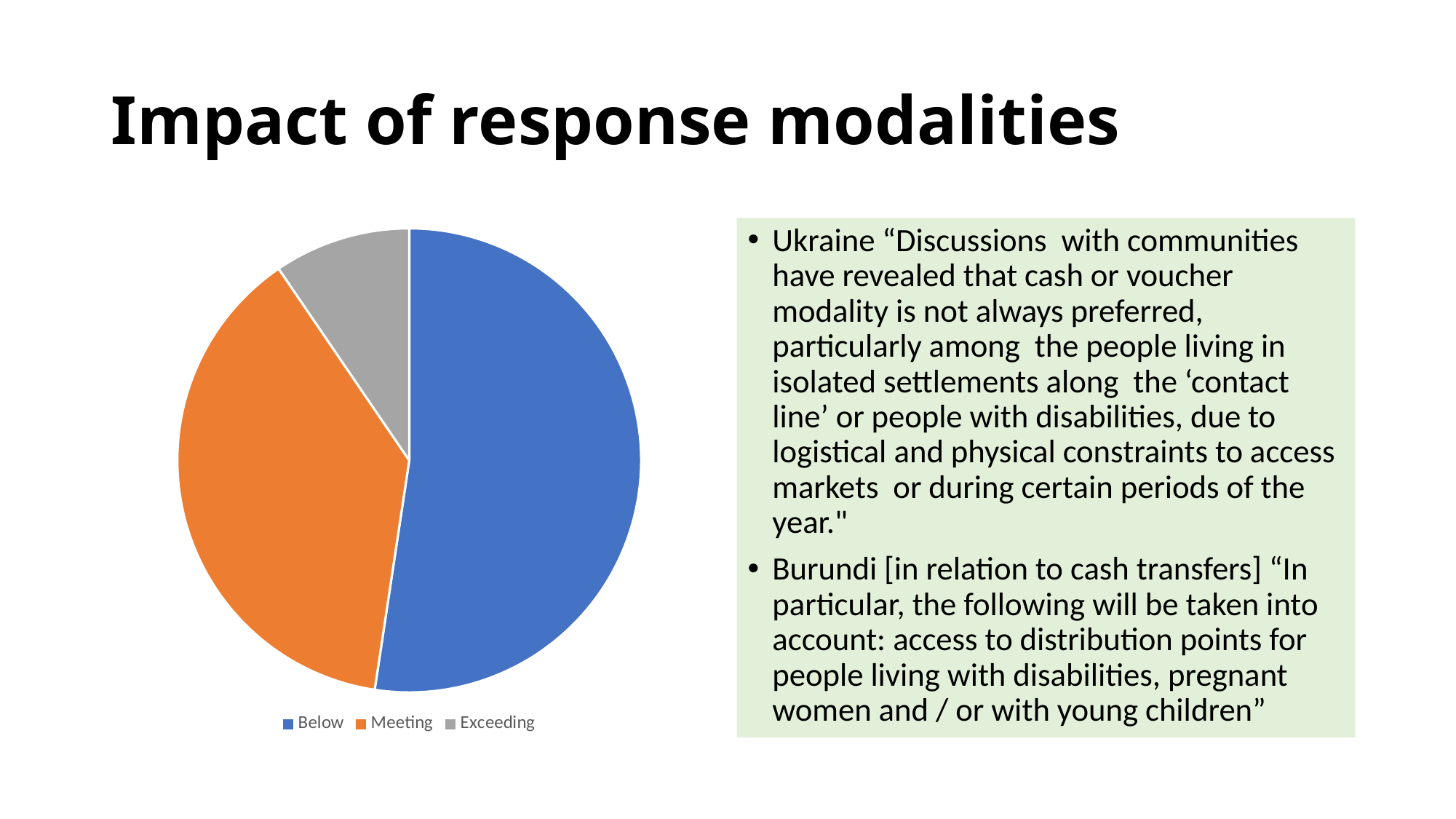
Which slice is larger in the pie chart, Meeting or Exceeding? Meeting Which slice is larger in the pie chart, Below or Meeting? Below Which slice is smaller in the pie chart, Below or Exceeding? Exceeding What are the three categories listed in the pie chart's legend? Below, Meeting, Exceeding What kind of chart is shown on the slide? Pie chart Which category has the smallest slice in the pie chart? Exceeding What colour is the Meeting slice in the pie chart? Orange Which category has the largest slice in the pie chart? Below How many entries does the legend of the pie chart list? 3 How many slices does the pie chart have? 3